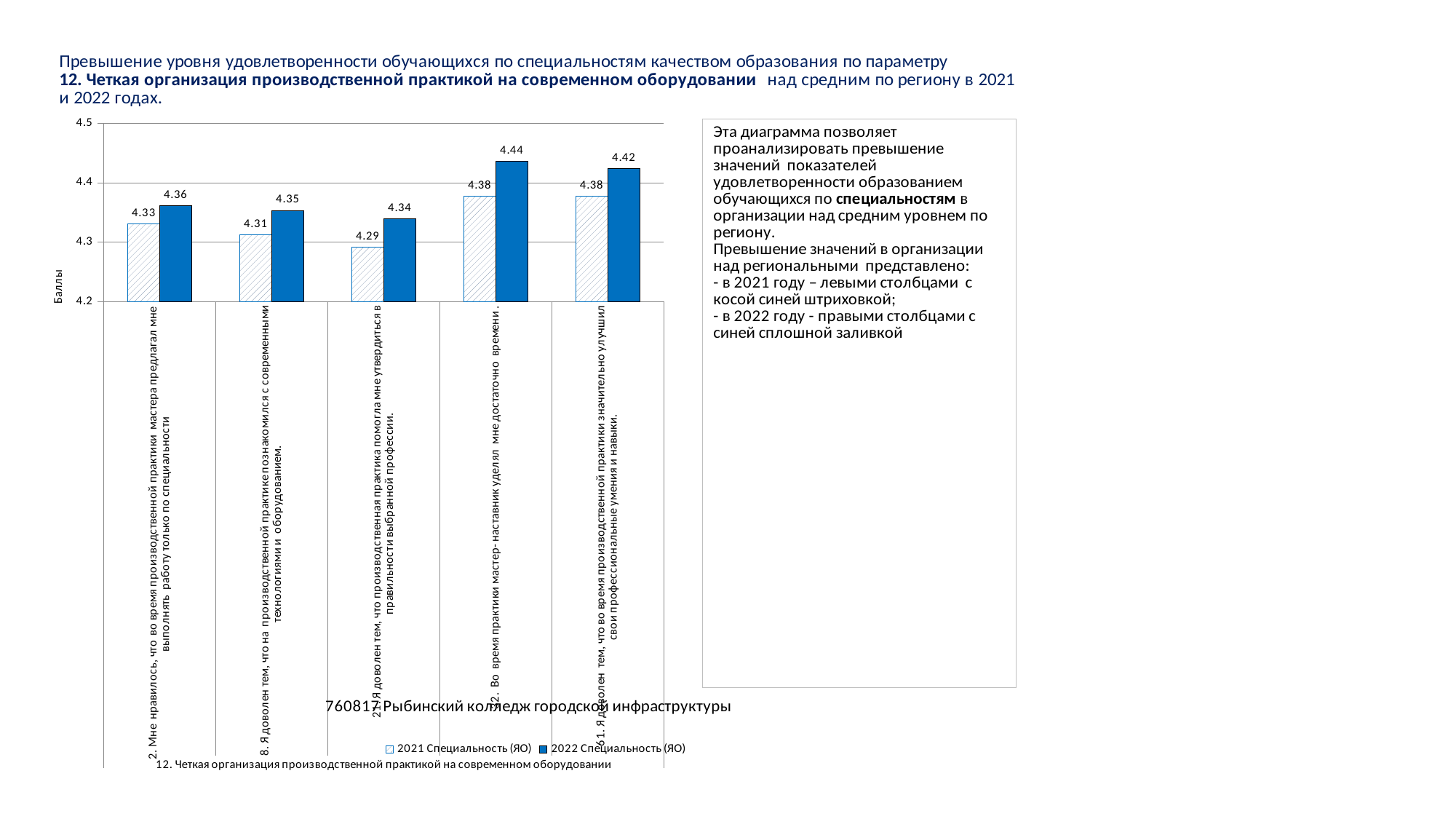
Which statement has the lowest 2021 Специальность (ЯО) value? 21. Я доволен тем, что производственная практика помогла мне утвердиться в правильности выбранной профессии What is the label of the vertical axis of the chart? Баллы For statement 32, what is the difference between the 2022 value and the 2021 value? 0.06 Which statement has the highest 2022 Специальность (ЯО) value? 32. Во время практики мастер-наставник уделял мне достаточно времени What is the 2022 Специальность (ЯО) value for statement 32 (Во время практики мастер-наставник уделял мне достаточно времени)? 4.44 Which is larger: the 2022 value for statement 8 or the 2022 value for statement 61? Statement 61 (4.42) What are the two legend entries of the chart? 2021 Специальность (ЯО) and 2022 Специальность (ЯО) What is the 2021 Специальность (ЯО) value for statement 27 (Я доволен тем, что производственная практика помогла мне утвердиться в правильности выбранной профессии)? 4.29 What kind of chart is shown on the slide? Bar chart Is the 2021 value for statement 2 (Мне нравилось, что во время производственной практики мастера предлагал мне выполнять работу только по специальности) greater or less than 4.4? less How many categories (statements) are plotted on the x axis of the chart? 5 How many series does the chart legend list? 2